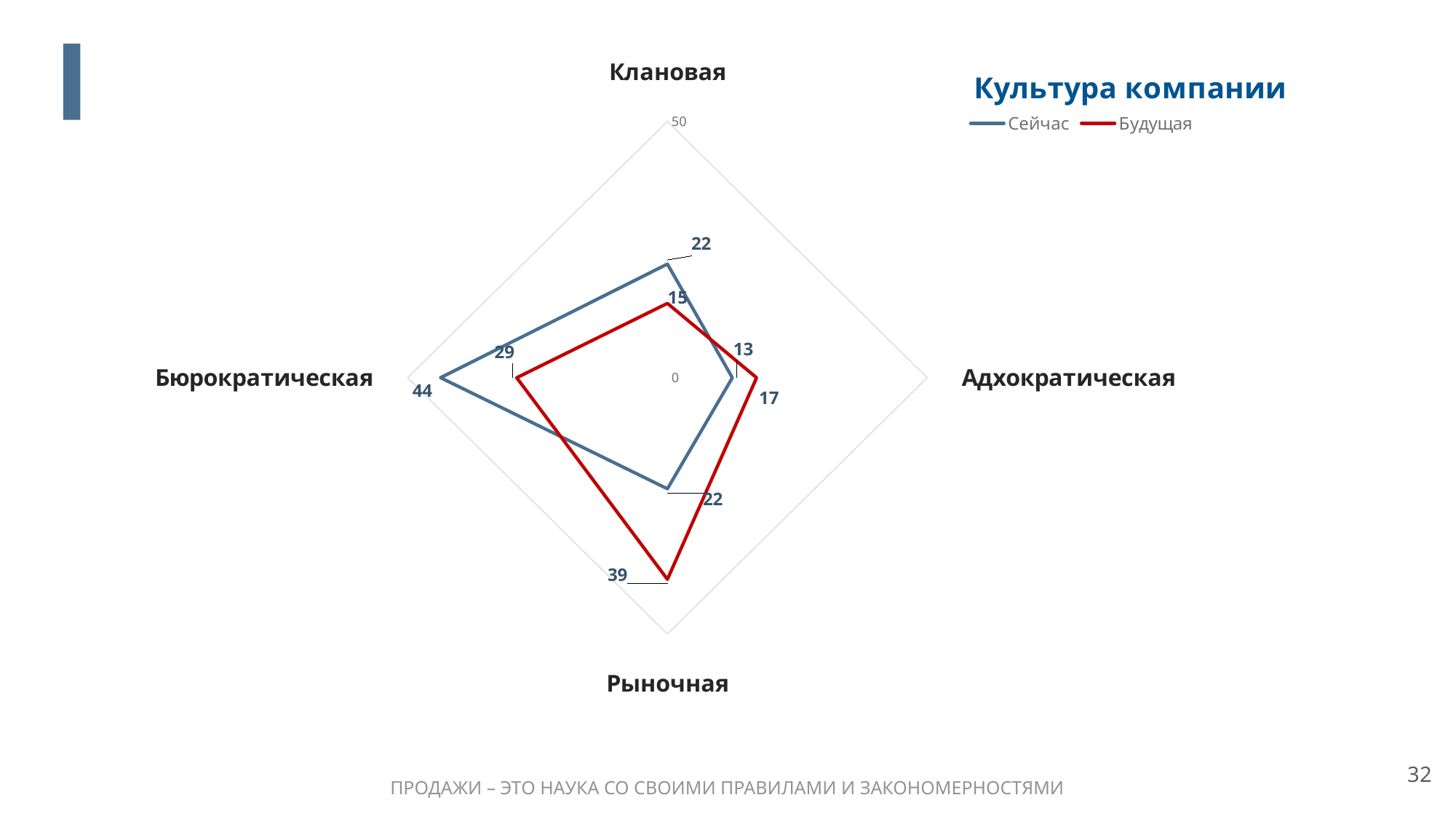
What is the value of the Будущая series for Рыночная? 39 How many categories (axes) does the radar chart have? 4 What is the value of the Сейчас series for Бюрократическая? 44 What is the value of the Сейчас series for Адхократическая? 13 Which category has the lowest value in the Будущая series? Клановая What is the title of the chart? Культура компании What is the value of the Будущая series for Клановая? 15 What is the difference between the Сейчас and Будущая values for Бюрократическая? 15 Which category has the highest value in the Сейчас series? Бюрократическая For Рыночная, which series has the larger value, Сейчас or Будущая? Будущая What type of chart is shown on the slide? radar chart How many series does the legend list? 2